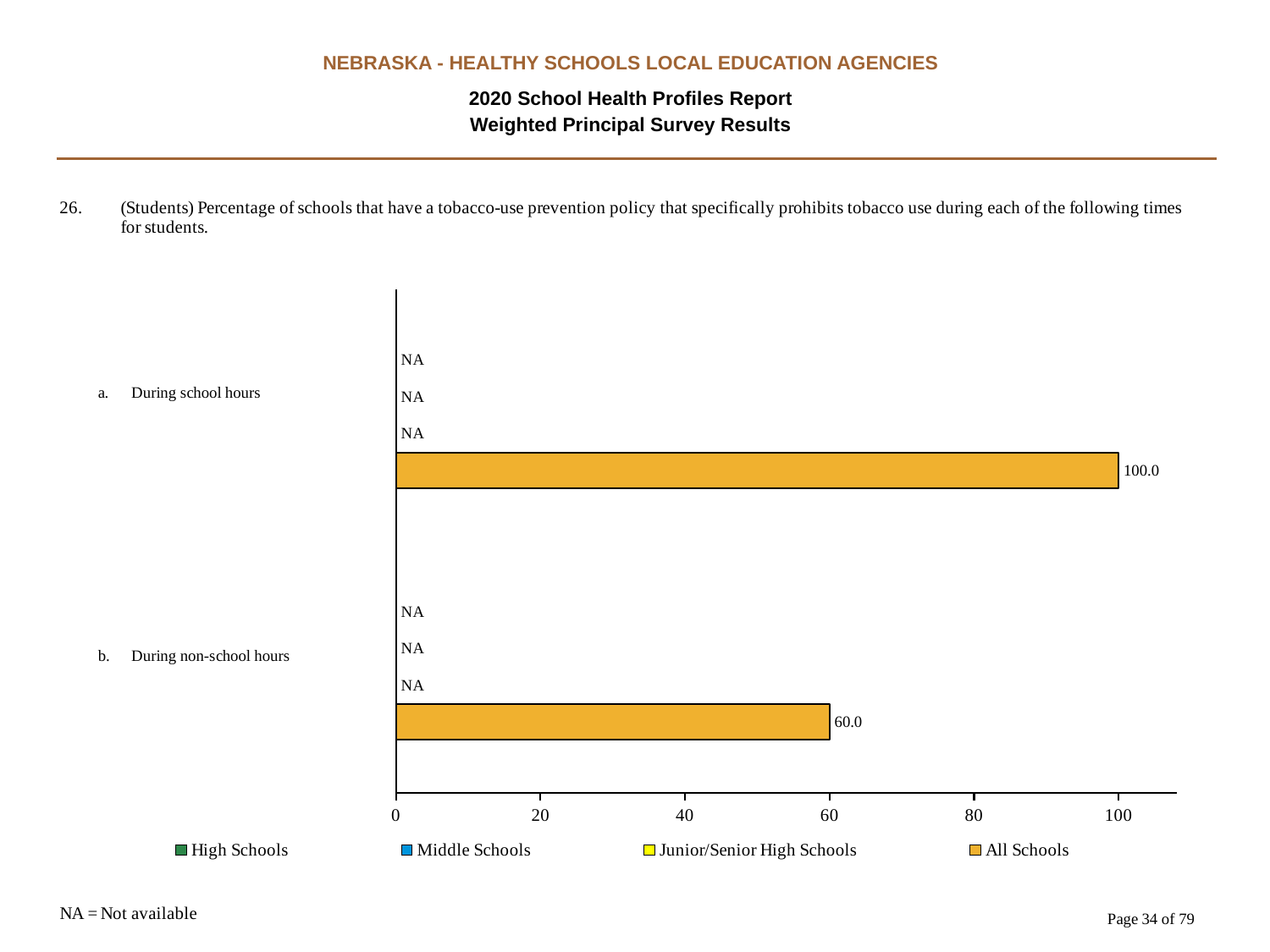
How many categories are shown on the chart? 2 What is the value for All Schools for 'During school hours'? 100.0 What value is shown for High Schools for 'During school hours'? NA What value is shown for Middle Schools for 'During non-school hours'? NA What is the difference between the All Schools values for 'During school hours' and 'During non-school hours'? 40.0 Which category has the lowest All Schools value? During non-school hours What does NA stand for according to the note on the slide? Not available How many series does the legend list? 4 Is the All Schools value for 'During non-school hours' greater or less than 80? less What kind of chart is shown on the slide? bar chart Which category has the higher All Schools value, 'During school hours' or 'During non-school hours'? During school hours What is the value for All Schools for 'During non-school hours'? 60.0